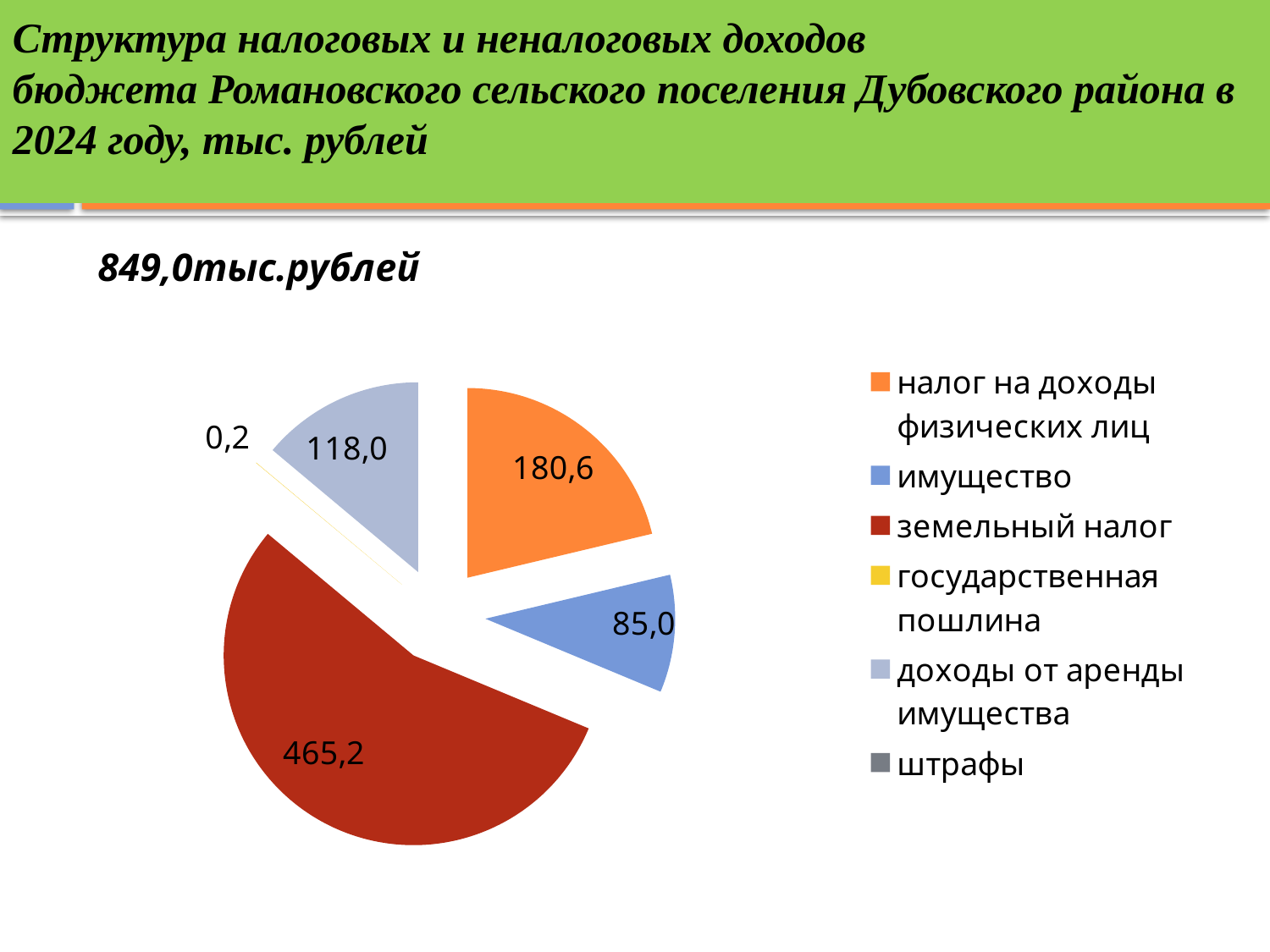
What is the value for государственная пошлина? 0,2 What type of chart is shown on the slide? pie chart Which is larger, доходы от аренды имущества or имущество? доходы от аренды имущества What is the value for имущество? 85,0 What is the difference between земельный налог and налог на доходы физических лиц? 284,6 What is the value for земельный налог? 465,2 What is the value for доходы от аренды имущества? 118,0 What is the value for налог на доходы физических лиц? 180,6 What total amount is stated above the chart? 849,0тыс.рублей How many entries does the legend list? 6 Which category has the largest slice of the pie? земельный налог Which labelled category has the smallest value? государственная пошлина